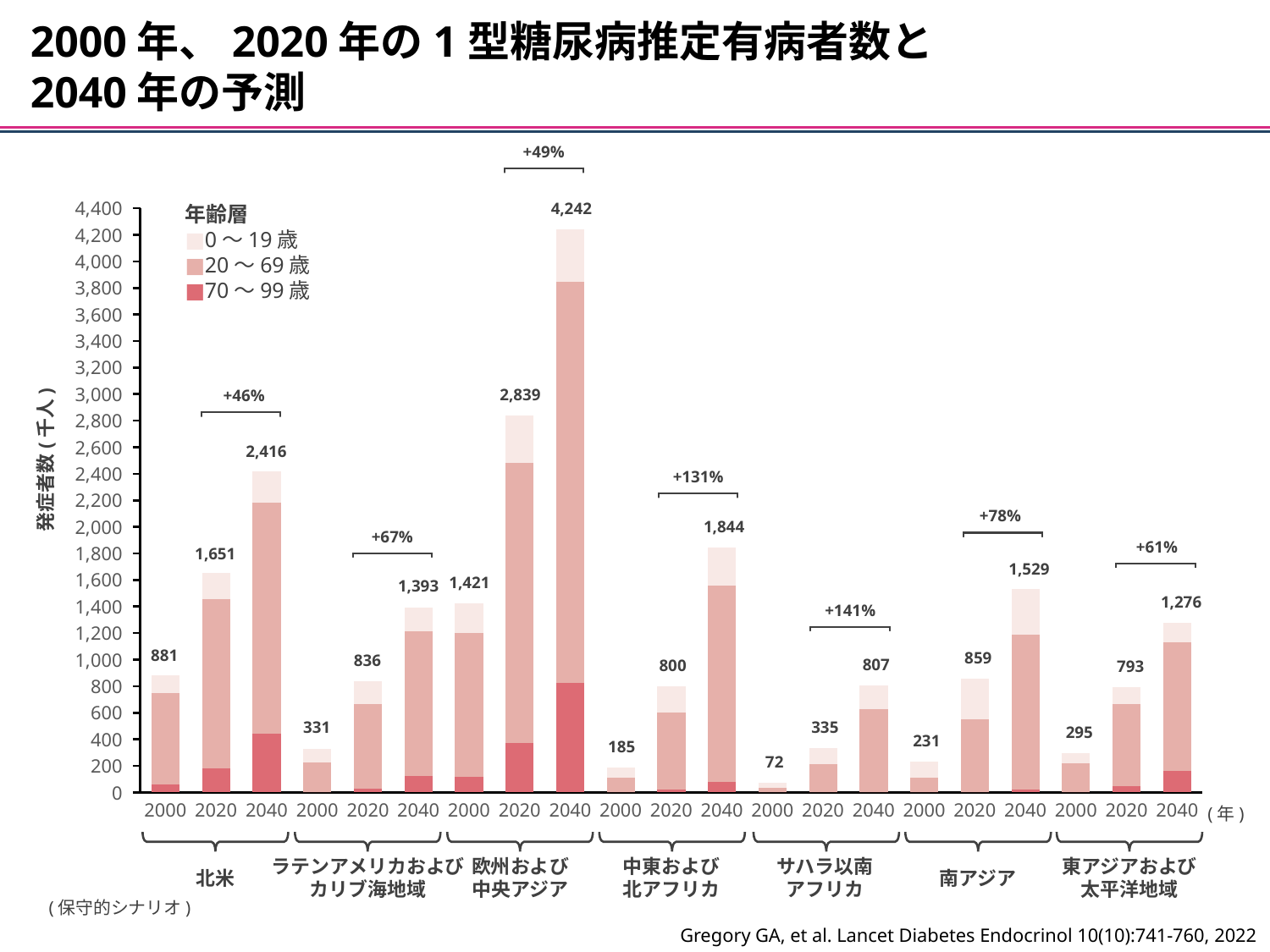
2040年の発症者数が最も多い地域はどこですか？ 欧州および中央アジア 凡例「年齢層」にはいくつの区分がありますか？ 3 これはどの種類のグラフですか？ 積み上げ棒グラフ 2020年の発症者数は、中東および北アフリカと東アジアおよび太平洋地域のどちらが多いですか？ 中東および北アフリカ 欧州および中央アジアの2020年の発症者数（千人）はいくつですか？ 2,839 2020年から2040年への増加率が最も高い地域として示されているのはどこですか？ サハラ以南アフリカ（+141%） ラテンアメリカおよびカリブ海地域の2040年の発症者数は1,200より多いですか、少ないですか？ 多い サハラ以南アフリカの2000年の発症者数（千人）はいくつですか？ 72 南アジアの2040年と2020年の発症者数の差（千人）はいくつですか？ 670 2000年の発症者数が最も少ない地域はどこですか？ サハラ以南アフリカ このグラフには何地域が示されていますか？ 7 北米の2040年の発症者数（千人）はいくつですか？ 2,416